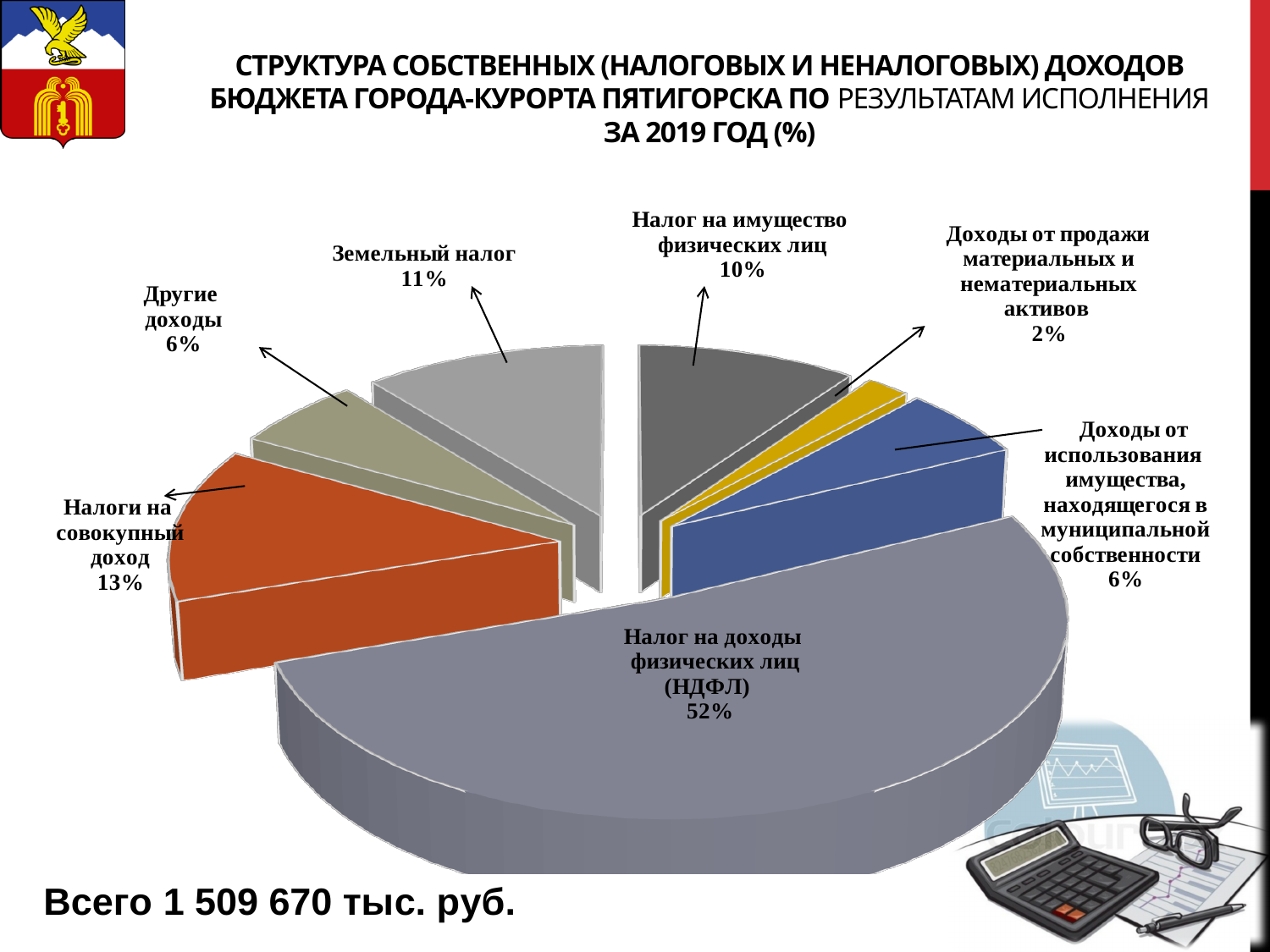
What is the difference in percentage points between "Налоги на совокупный доход" and "Земельный налог"? 2 What total amount of own revenues is stated at the bottom of the slide? 1 509 670 тыс. руб. Which is larger: the share of "Земельный налог" or the share of "Налог на имущество физических лиц"? Земельный налог What percentage is shown for "Налог на имущество физических лиц"? 10% Which category has the largest share of the pie? Налог на доходы физических лиц (НДФЛ) What percentage is shown for "Земельный налог"? 11% What percentage is shown for "Налоги на совокупный доход"? 13% How many categories (slices) does the pie chart have? 7 Which category has the smallest share of the pie? Доходы от продажи материальных и нематериальных активов What percentage is shown for "Доходы от продажи материальных и нематериальных активов"? 2% What type of chart is shown on the slide? Pie chart What share of the budget's own revenues does "Налог на доходы физических лиц (НДФЛ)" account for? 52%